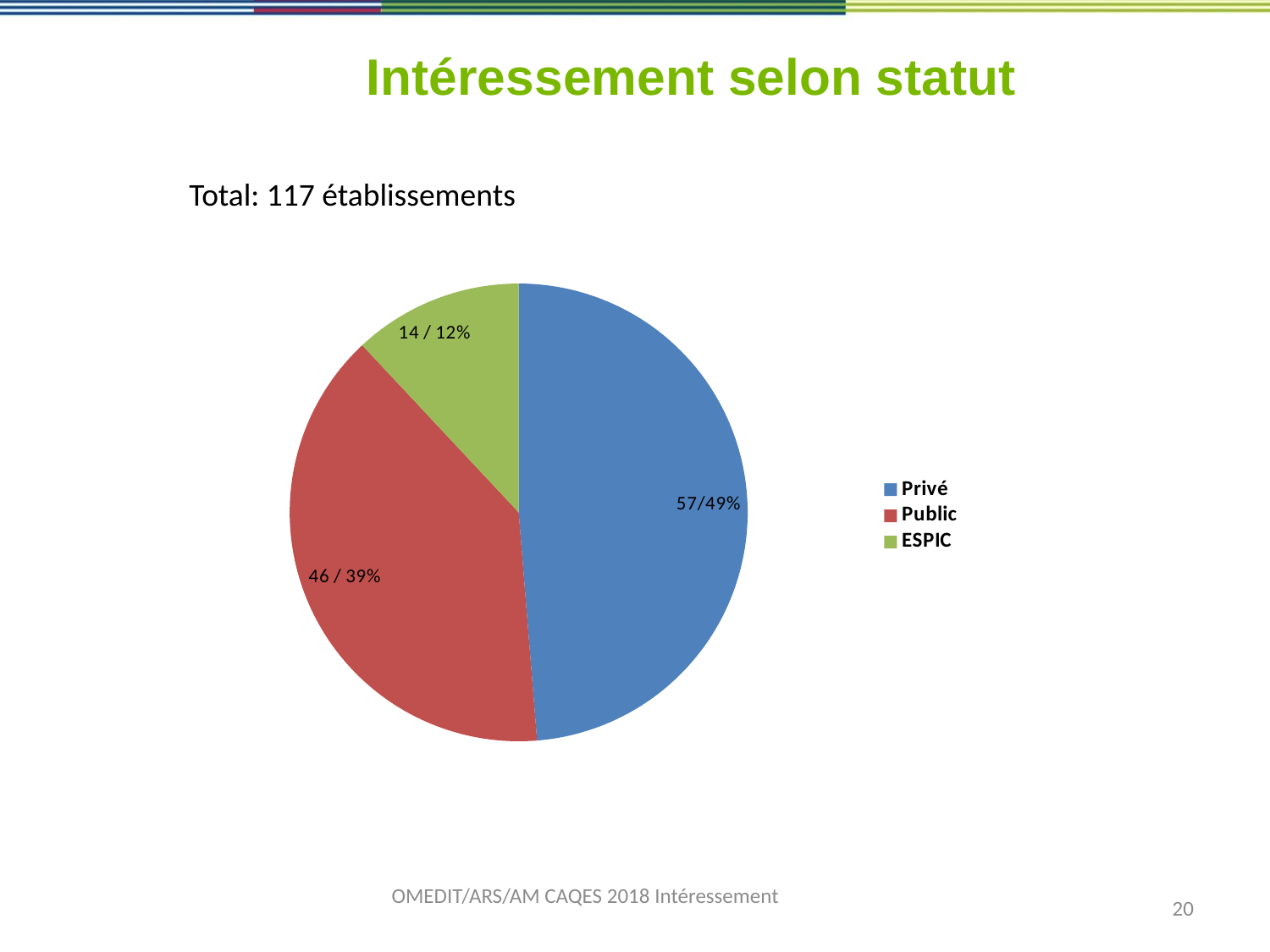
What is the data label shown for the Privé slice? 57/49% Which is larger, the Public slice or the ESPIC slice? Public What is the data label shown for the Public slice? 46 / 39% What is the title of the slide containing the chart? Intéressement selon statut What is the data label shown for the ESPIC slice? 14 / 12% What percentage share of the pie does Public represent? 39% How many more establishments are Privé than Public? 11 Which category has the smallest slice of the pie? ESPIC What kind of chart is shown on the slide? pie chart What percentage share of the pie does ESPIC represent? 12% How many categories does the pie chart have? 3 Which category has the largest slice of the pie? Privé